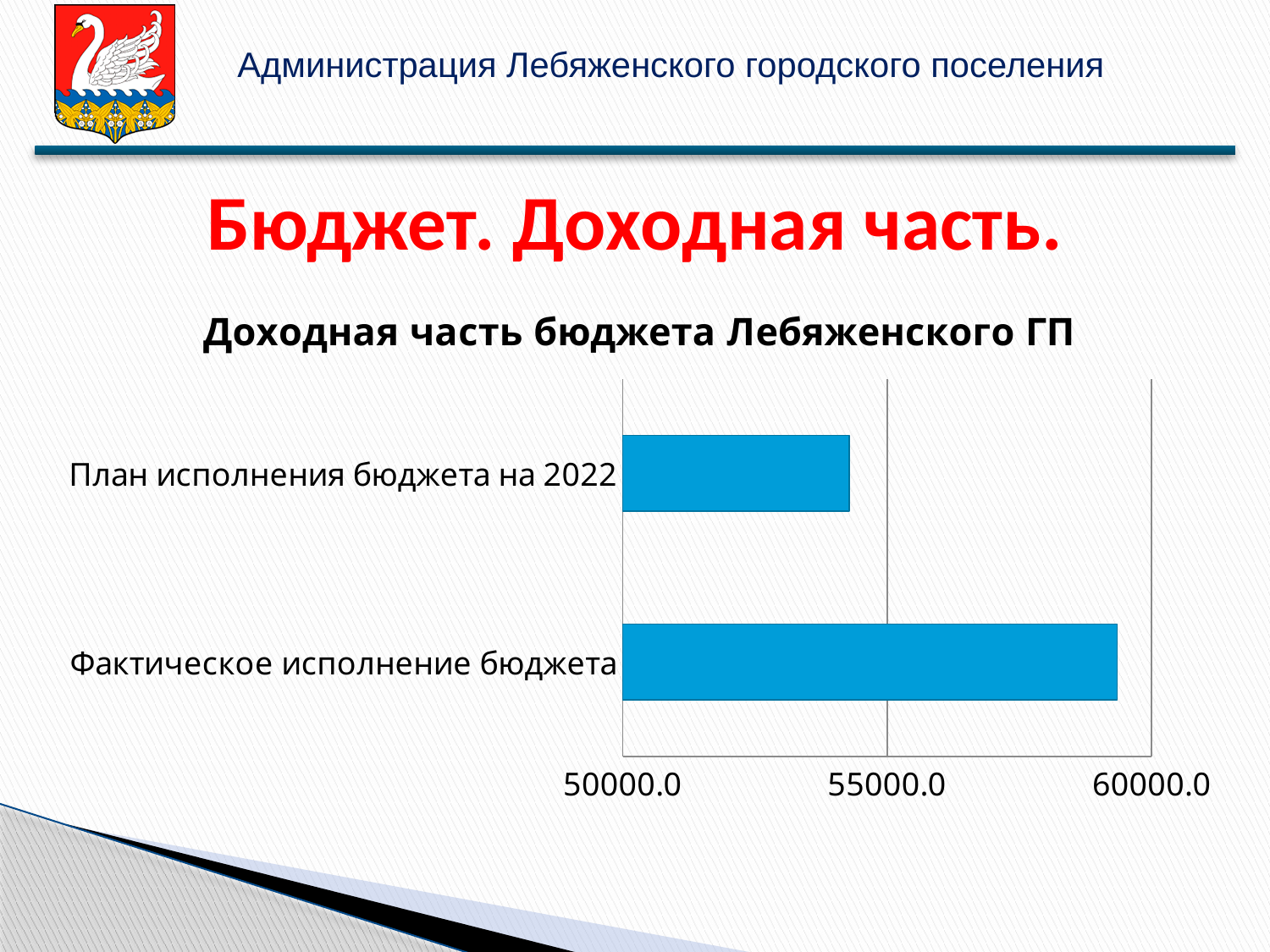
What is the title of the chart? Доходная часть бюджета Лебяженского ГП Is the value for Фактическое исполнение бюджета greater or less than 55000.0? greater How many categories are plotted in the chart? 2 Is the value for Фактическое исполнение бюджета greater or less than 60000.0? less Is the value for План исполнения бюджета на 2022 greater or less than 55000.0? less What kind of chart is shown on the slide? bar chart What is the highest value shown on the chart's horizontal axis? 60000.0 Which is larger: the value for План исполнения бюджета на 2022 or the value for Фактическое исполнение бюджета? Фактическое исполнение бюджета Which category has the lowest value in the chart? План исполнения бюджета на 2022 Which category has the highest value in the chart? Фактическое исполнение бюджета